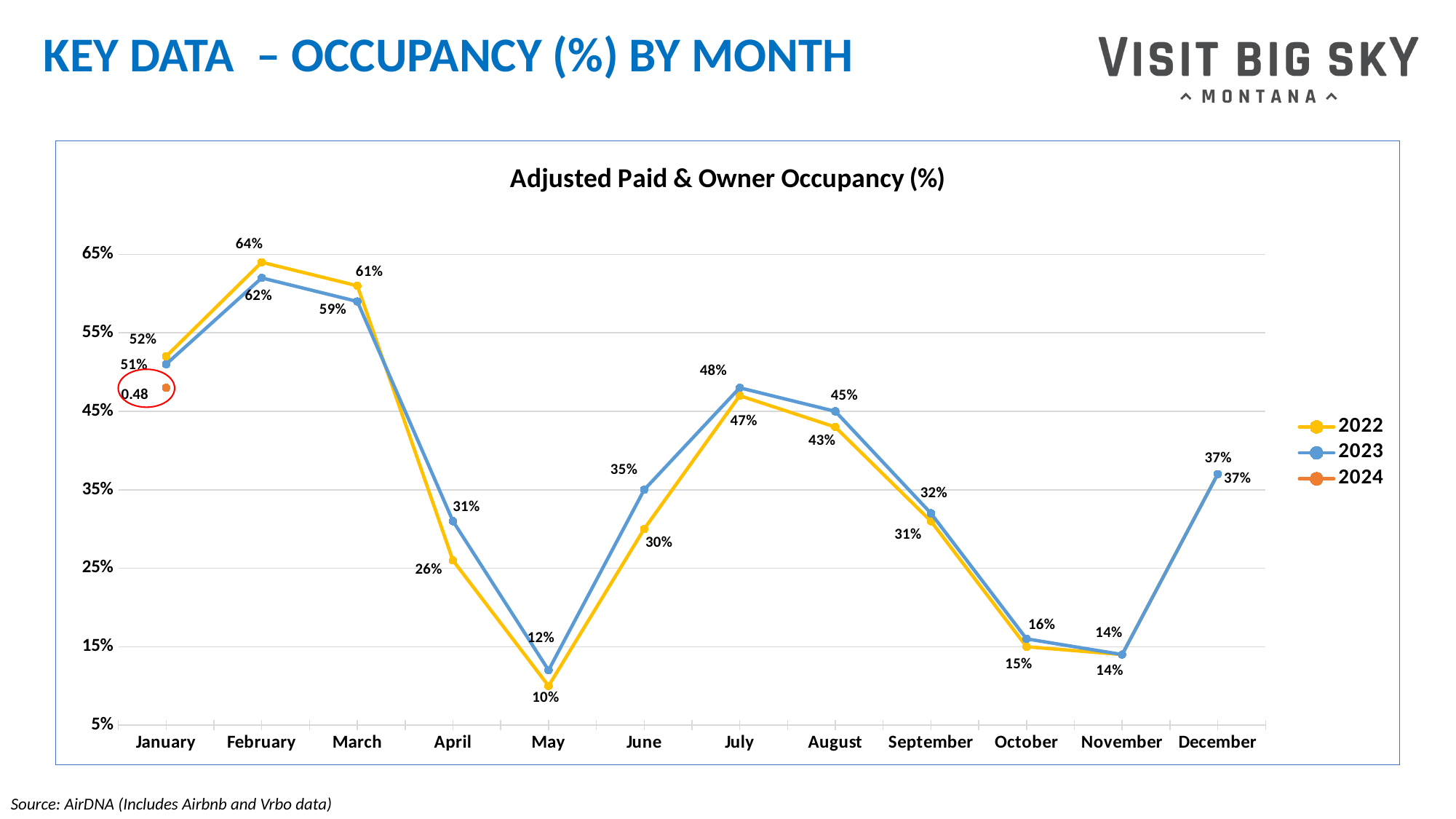
How many months are shown on the x axis? 12 Do the 2023 values rise or fall from February to May? Fall Which month has the highest 2023 occupancy value? February What value is shown for the 2024 series in January? 0.48 Which month has the lowest 2022 occupancy value? May What is the title of the chart? Adjusted Paid & Owner Occupancy (%) What is the difference between the 2023 and 2022 values for April? 5% What is the 2023 occupancy value for June? 35% Which is larger in March, the 2022 value or the 2023 value? 2022 How many series does the legend list? 3 What kind of chart is shown on the slide? Line chart What is the 2022 occupancy value for February? 64%